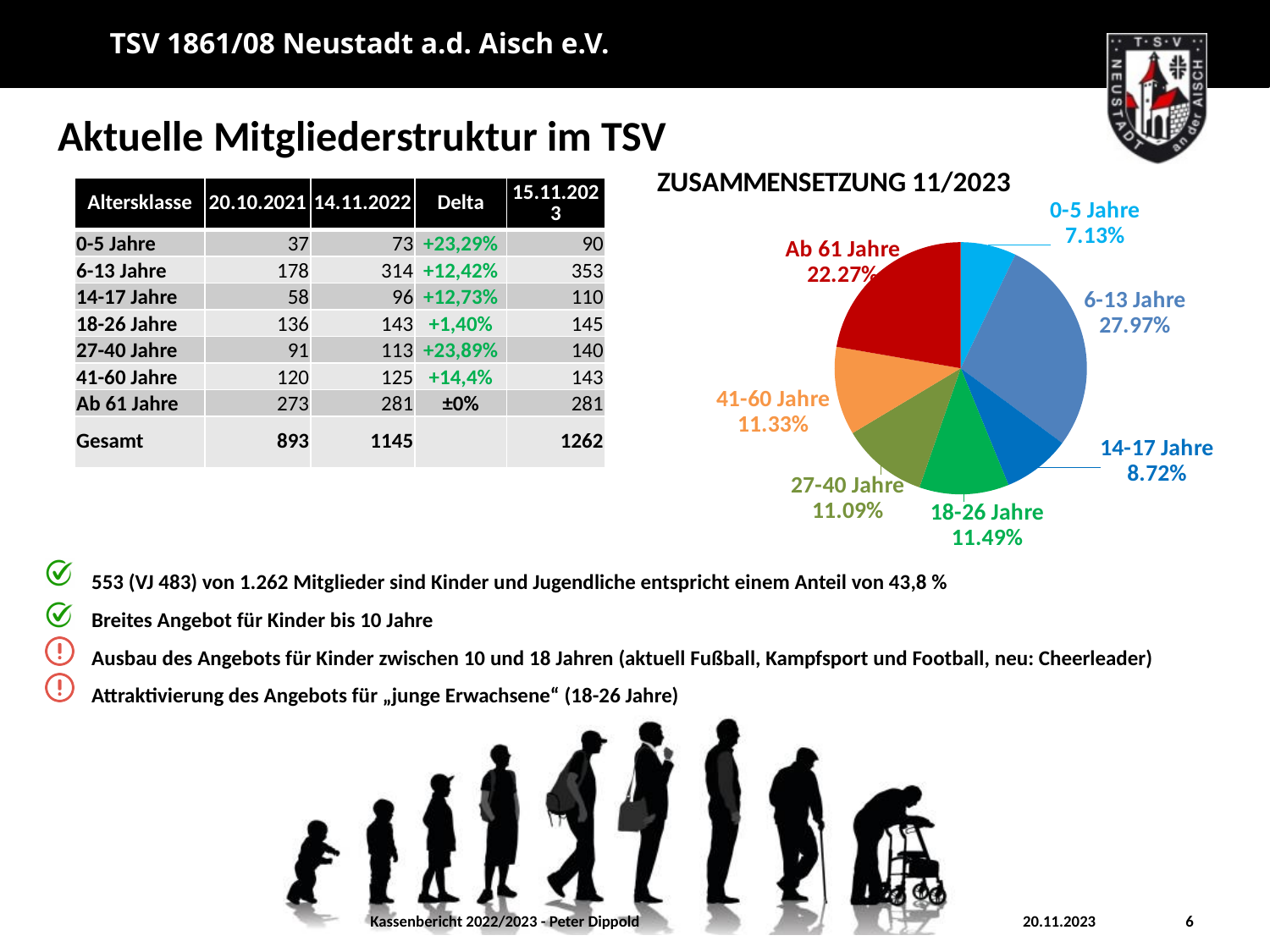
What percentage is shown for the 14-17 Jahre slice? 8.72% What is the title of the pie chart? ZUSAMMENSETZUNG 11/2023 How many slices does the pie chart have? 7 What colour is the Ab 61 Jahre slice? red What percentage is shown for the 41-60 Jahre slice? 11.33% Which slice is larger, 18-26 Jahre or 27-40 Jahre? 18-26 Jahre Which age group has the smallest share of the pie? 0-5 Jahre What type of chart is shown on the slide? pie chart Which age group has the largest share of the pie? 6-13 Jahre What share of the pie does the 6-13 Jahre slice represent? 27.97% What is the difference in percentage points between the 6-13 Jahre slice and the Ab 61 Jahre slice? 5.70% What percentage is shown for the Ab 61 Jahre slice? 22.27%